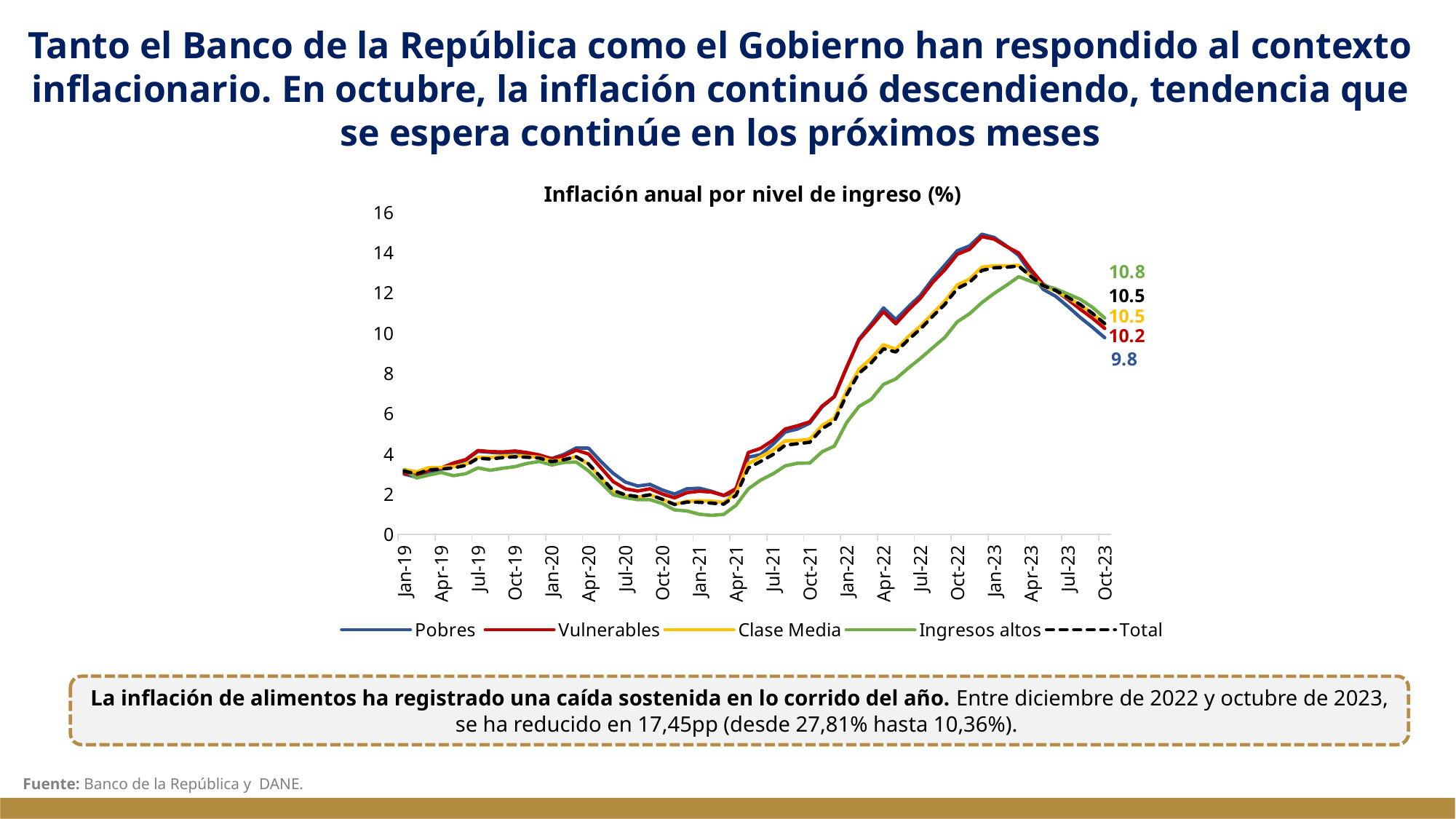
Do the values for Total rise or fall between Jan-23 and Oct-23? fall What is the title of the chart? Inflación anual por nivel de ingreso (%) What type of chart is shown on the slide? line chart What is the difference between the Oct-23 values for Ingresos altos and Pobres? 1.0 What is the value for Vulnerables at Oct-23? 10.2 What is the value for Total at Oct-23? 10.5 Which series has the highest value at Oct-23? Ingresos altos Which series has the lowest value at Oct-23? Pobres What is the value for Ingresos altos at Oct-23? 10.8 How many series does the legend list? 5 What is the value for Pobres at Oct-23? 9.8 Is the value for Pobres at Jan-23 greater or less than 14? greater